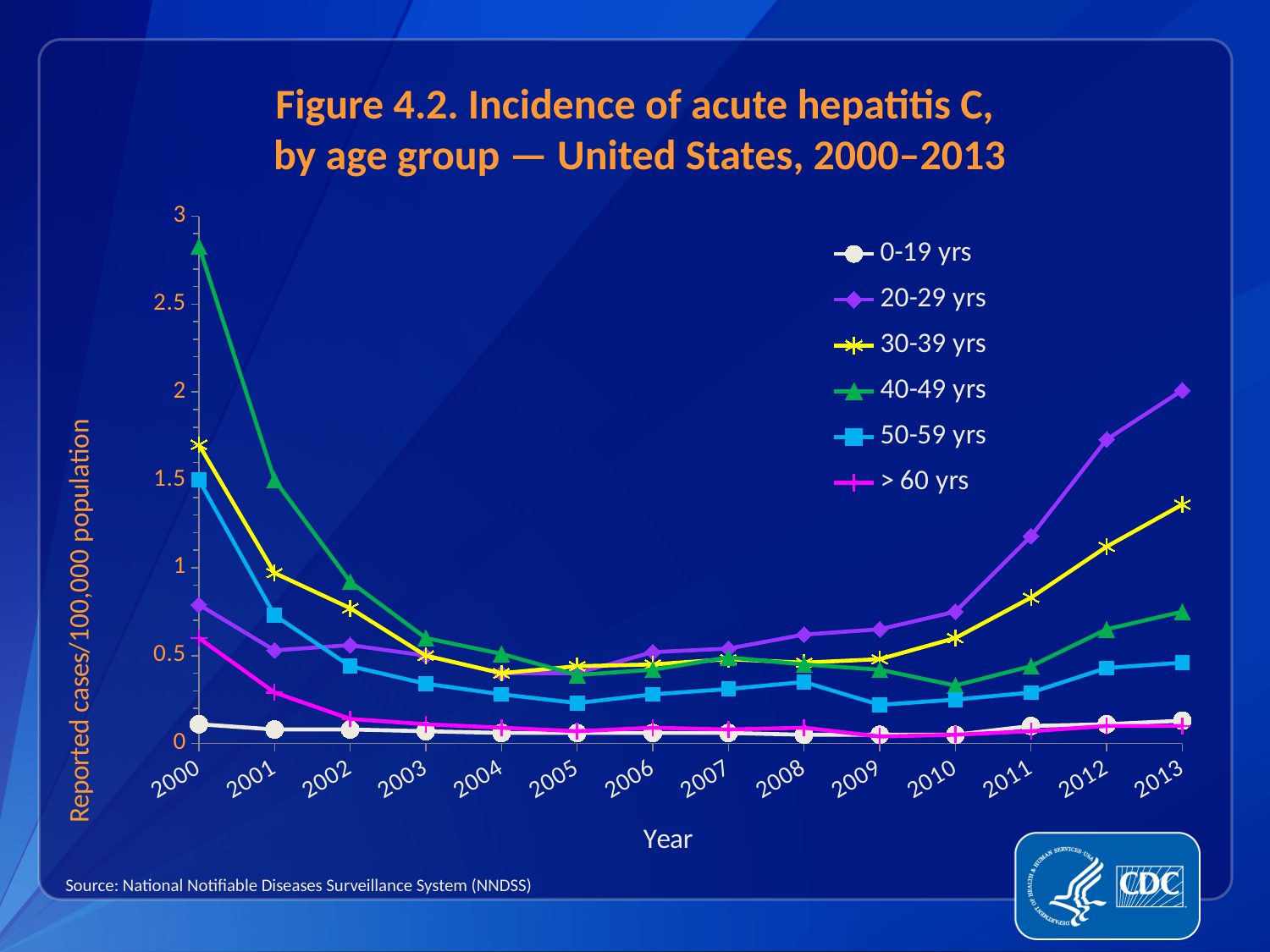
Does the incidence for 20-29 yrs rise or fall from 2010 to 2013? rise What kind of chart is shown on the slide? line chart Which age group has the highest incidence in 2000? 40-49 yrs Is the value for 40-49 yrs in 2000 greater or less than 2.5? greater What is the label on the y axis? Reported cases/100,000 population Is the value for 30-39 yrs in 2013 greater or less than 1.5? less Which age group has the lowest incidence in 2000? 0-19 yrs Is the value for 20-29 yrs in 2012 greater or less than 1.5? greater How many age-group series does the legend list? 6 Which age group has the highest incidence in 2013? 20-29 yrs In 2013, which is larger: the value for 30-39 yrs or the value for 40-49 yrs? 30-39 yrs How many years are plotted along the x axis? 14